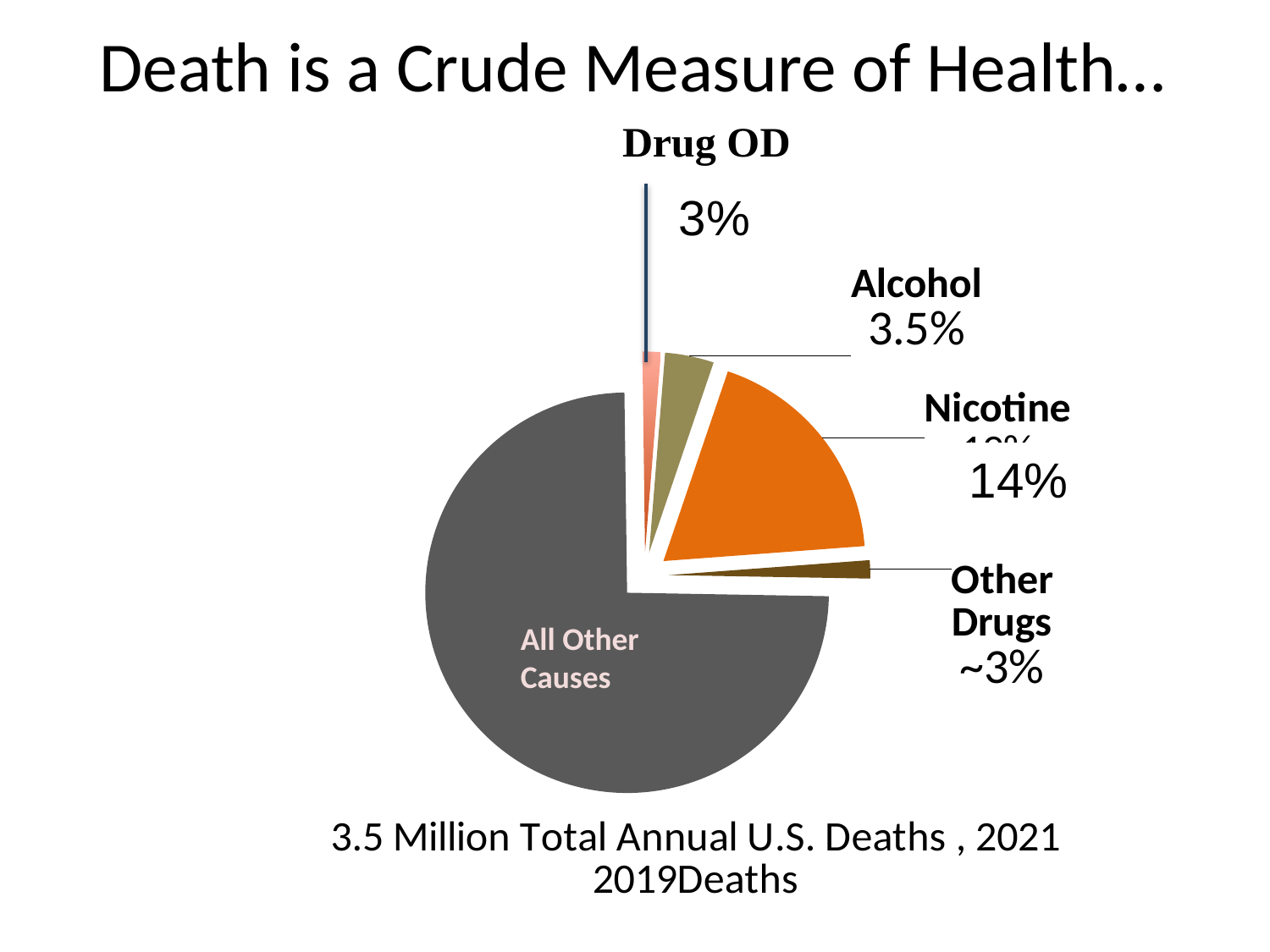
Which slice of the pie chart is the largest? All Other Causes What percentage of deaths is attributed to Alcohol? 3.5% How many slices does the pie chart have? 5 What is the difference between the Nicotine share and the Alcohol share? 10.5% What is the difference between the Alcohol share and the Drug OD share? 0.5% What kind of chart is shown on the slide? pie chart What percentage of deaths is attributed to Nicotine? 14% Which is larger, the Nicotine share or the Alcohol share? Nicotine What percentage of deaths is attributed to Drug OD? 3% What colour is the All Other Causes slice? grey According to the text below the chart, how many total annual U.S. deaths were there in 2021? 3.5 Million Which is larger, the Alcohol share or the Drug OD share? Alcohol